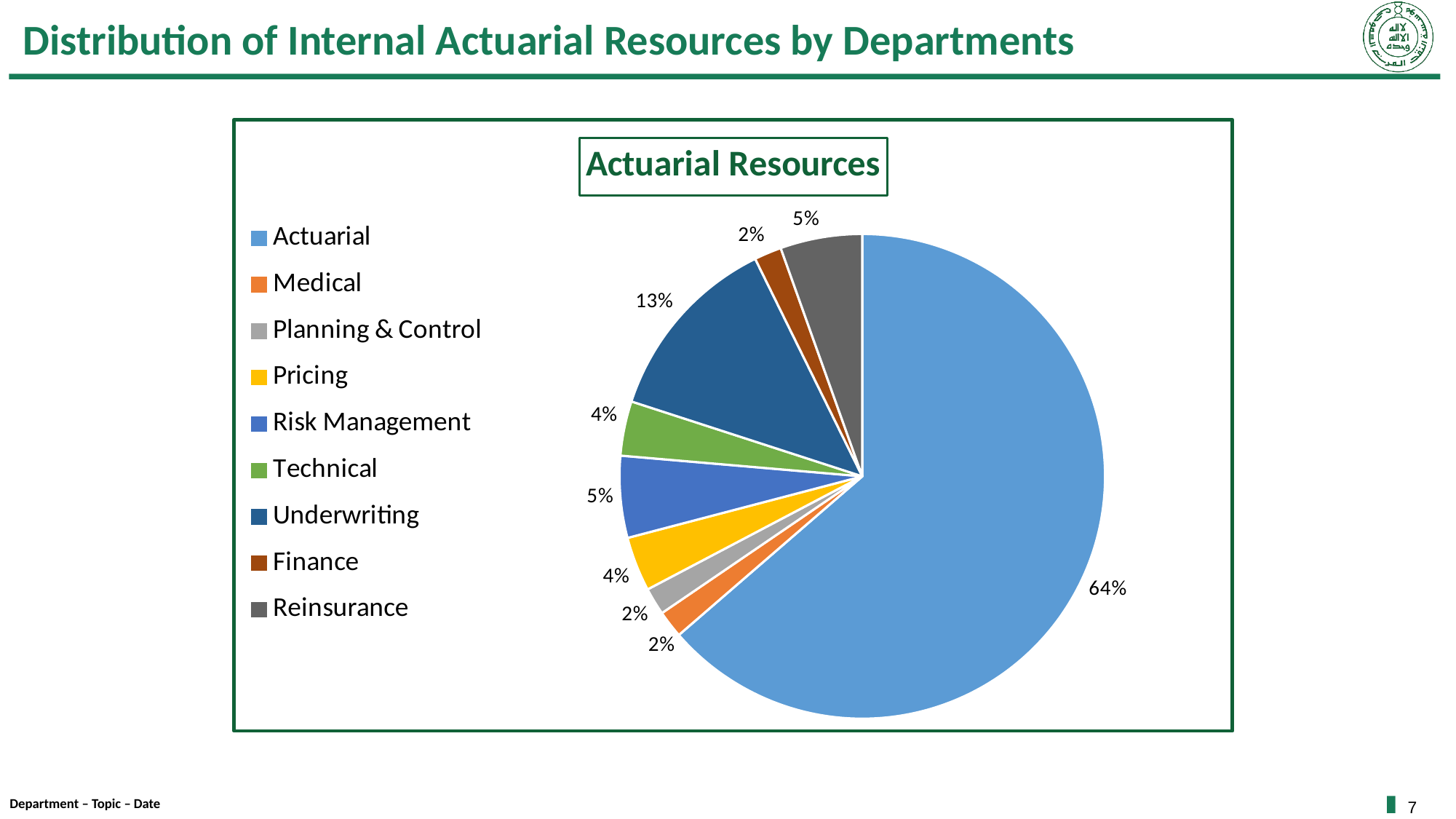
What is the difference in percentage points between the Actuarial and Underwriting shares? 51% What percentage is shown for Underwriting? 13% What percentage is shown for Technical? 4% What is the title of the chart? Actuarial Resources What percentage is shown for Risk Management? 5% Which has a larger share, Underwriting or Reinsurance? Underwriting Which department has the largest share of the pie? Actuarial What share of the pie does the Actuarial department hold? 64% What percentage is shown for Finance? 2% What kind of chart is shown on the slide? pie chart What colour is the Pricing slice in the pie chart? yellow How many departments are listed in the chart legend? 9